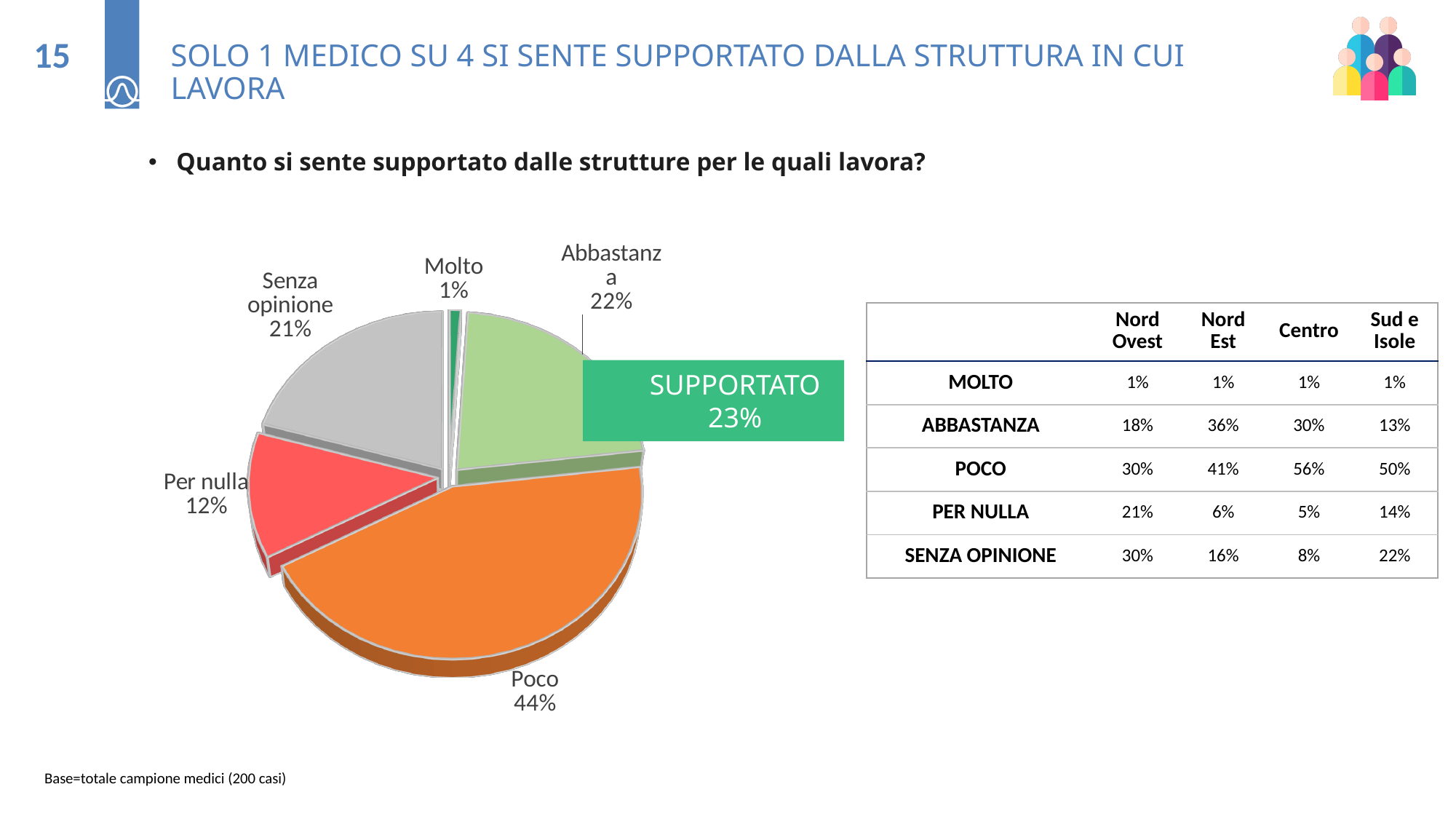
What is the difference in percentage points between the 'Poco' slice and the 'Abbastanza' slice? 22 What percentage of the pie chart is the 'Poco' slice? 44% What percentage of the pie chart is the 'Abbastanza' slice? 22% What percentage of the pie chart is the 'Senza opinione' slice? 21% What percentage of the pie chart is the 'Per nulla' slice? 12% What value is shown in the green 'SUPPORTATO' callout box next to the pie chart? 23% Which slice is larger in the pie chart, 'Senza opinione' or 'Per nulla'? Senza opinione Which category has the smallest slice in the pie chart? Molto What kind of chart is shown on the slide? Pie chart What percentage of the pie chart is the 'Molto' slice? 1% How many slices does the pie chart have? 5 Which category has the largest slice in the pie chart? Poco